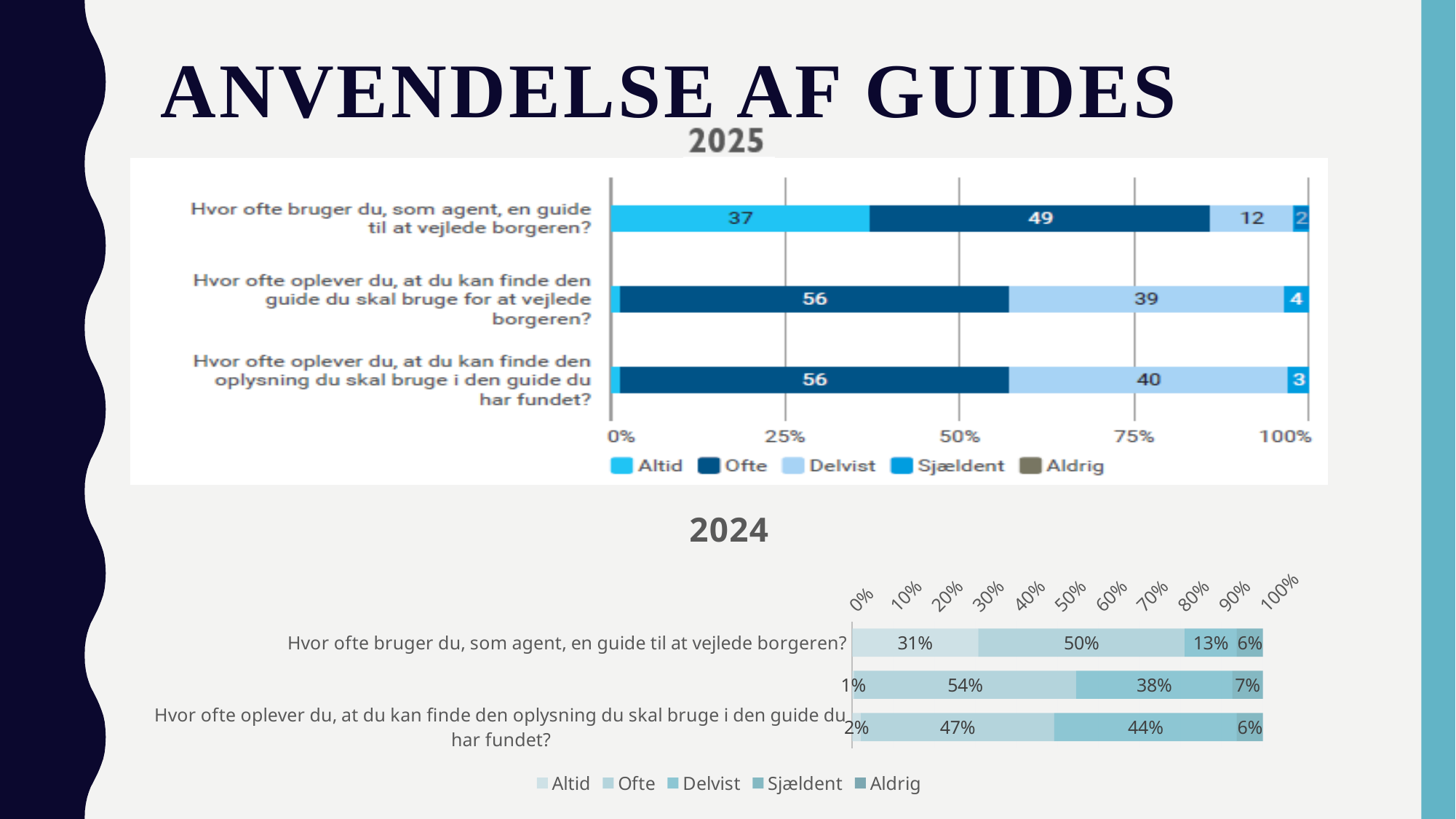
In the 2025 chart, what is the value for "Altid" for the question "Hvor ofte bruger du, som agent, en guide til at vejlede borgeren?"? 37 In the 2025 chart, what is the difference between the "Ofte" and "Altid" values for the question "Hvor ofte bruger du, som agent, en guide til at vejlede borgeren?"? 12 In the 2024 chart, which is larger for the question "Hvor ofte bruger du, som agent, en guide til at vejlede borgeren?": the "Altid" value or the "Ofte" value? Ofte In the 2025 chart, what is the value for "Ofte" for the question "Hvor ofte bruger du, som agent, en guide til at vejlede borgeren?"? 49 In the 2024 chart, what is the "Ofte" value for the question "Hvor ofte bruger du, som agent, en guide til at vejlede borgeren?"? 50% In the 2024 chart, what is the "Delvist" value for the question "Hvor ofte oplever du, at du kan finde den oplysning du skal bruge i den guide du har fundet?"? 44% In the 2025 chart, which segment is largest for the question "Hvor ofte oplever du, at du kan finde den guide du skal bruge for at vejlede borgeren?"? Ofte How many bars does the 2024 chart show? 3 In the 2025 chart, what is the value for "Sjældent" for the question "Hvor ofte oplever du, at du kan finde den guide du skal bruge for at vejlede borgeren?"? 4 What kind of chart is the 2025 chart? Stacked bar chart How many series does the legend of the 2025 chart list? 5 In the 2025 chart, what is the value for "Delvist" for the question "Hvor ofte oplever du, at du kan finde den oplysning du skal bruge i den guide du har fundet?"? 40